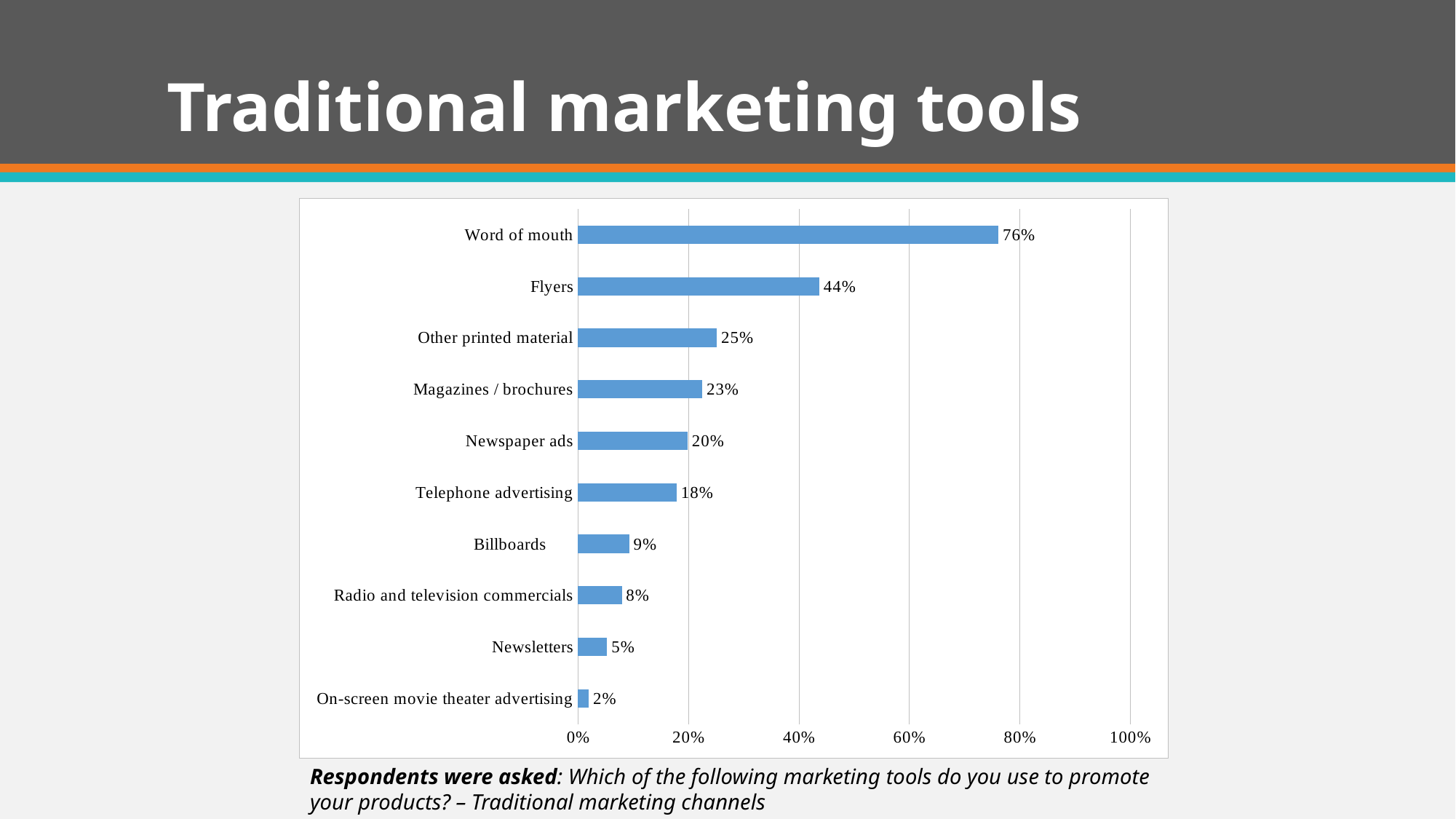
Is the value for Flyers greater or less than 40%? greater What is the value for Flyers? 44% What type of chart is shown on the slide? Bar chart Which marketing tool has the highest value? Word of mouth What is the difference between the values for Word of mouth and Flyers? 32% Which is larger, Other printed material or Magazines / brochures? Other printed material What percentage is shown for Telephone advertising? 18% What is the difference between Newspaper ads and Billboards? 11% Which marketing tool has the lowest value? On-screen movie theater advertising How many marketing tools are shown in the chart? 10 What is the value for On-screen movie theater advertising? 2% What percentage of respondents use word of mouth? 76%